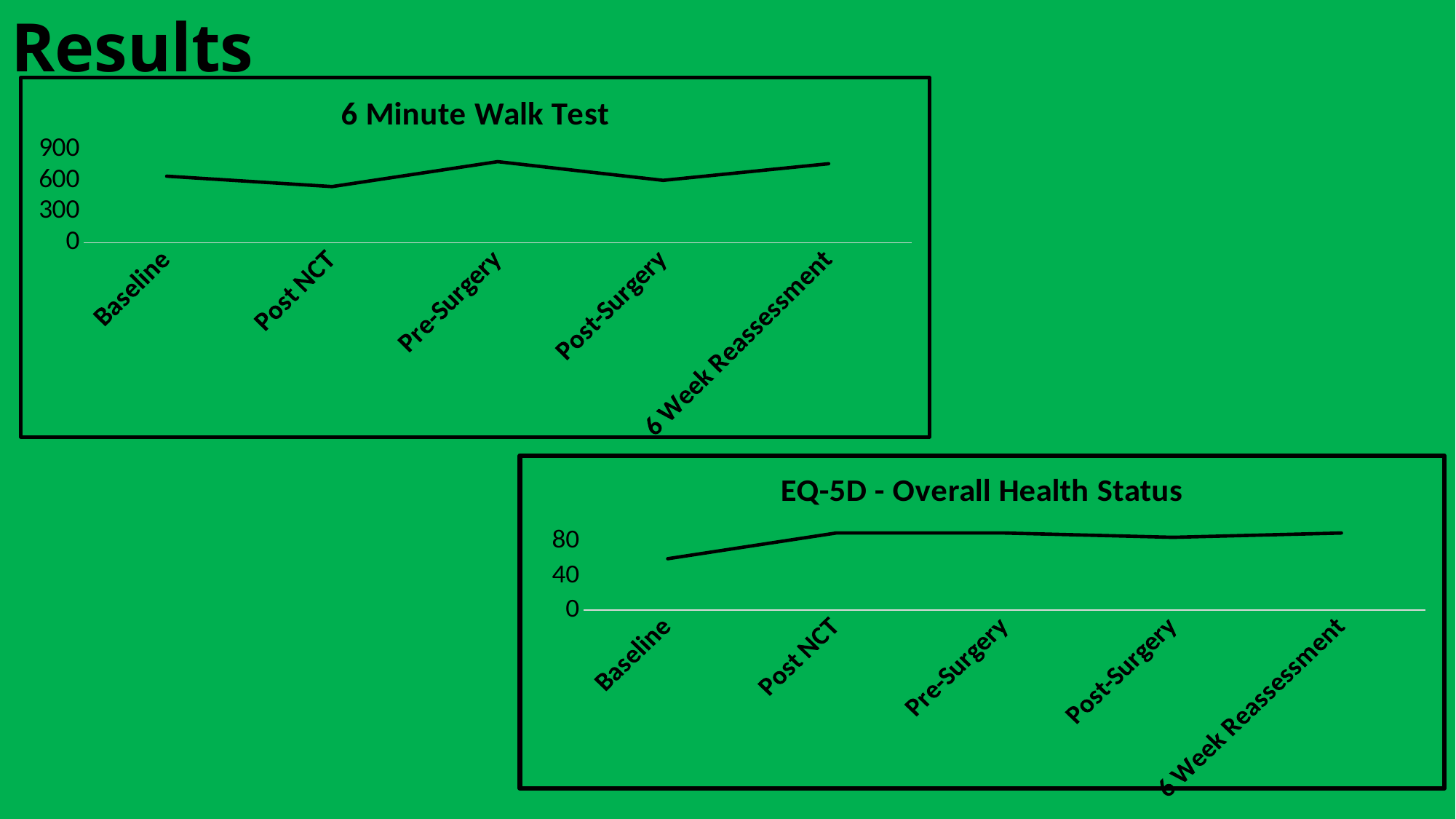
In the "6 Minute Walk Test" chart, which time point has the highest value? Pre-Surgery In the "6 Minute Walk Test" chart, which is larger, the value at Pre-Surgery or the value at Post-Surgery? Pre-Surgery What type of chart is the "EQ-5D - Overall Health Status" chart? line chart In the "6 Minute Walk Test" chart, is the value for Pre-Surgery greater or less than 600? greater In the "EQ-5D - Overall Health Status" chart, does the value rise or fall from Baseline to Post NCT? rise In the "EQ-5D - Overall Health Status" chart, which time point has the lowest value? Baseline In the "6 Minute Walk Test" chart, which time point has the lowest value? Post NCT What type of chart is the "6 Minute Walk Test" chart? line chart In the "6 Minute Walk Test" chart, is the value for Post NCT greater or less than 600? less In the "EQ-5D - Overall Health Status" chart, is the value for Baseline greater or less than 40? greater How many time points are plotted on the "6 Minute Walk Test" chart? 5 What is the title of the chart in the lower right of the slide? EQ-5D - Overall Health Status